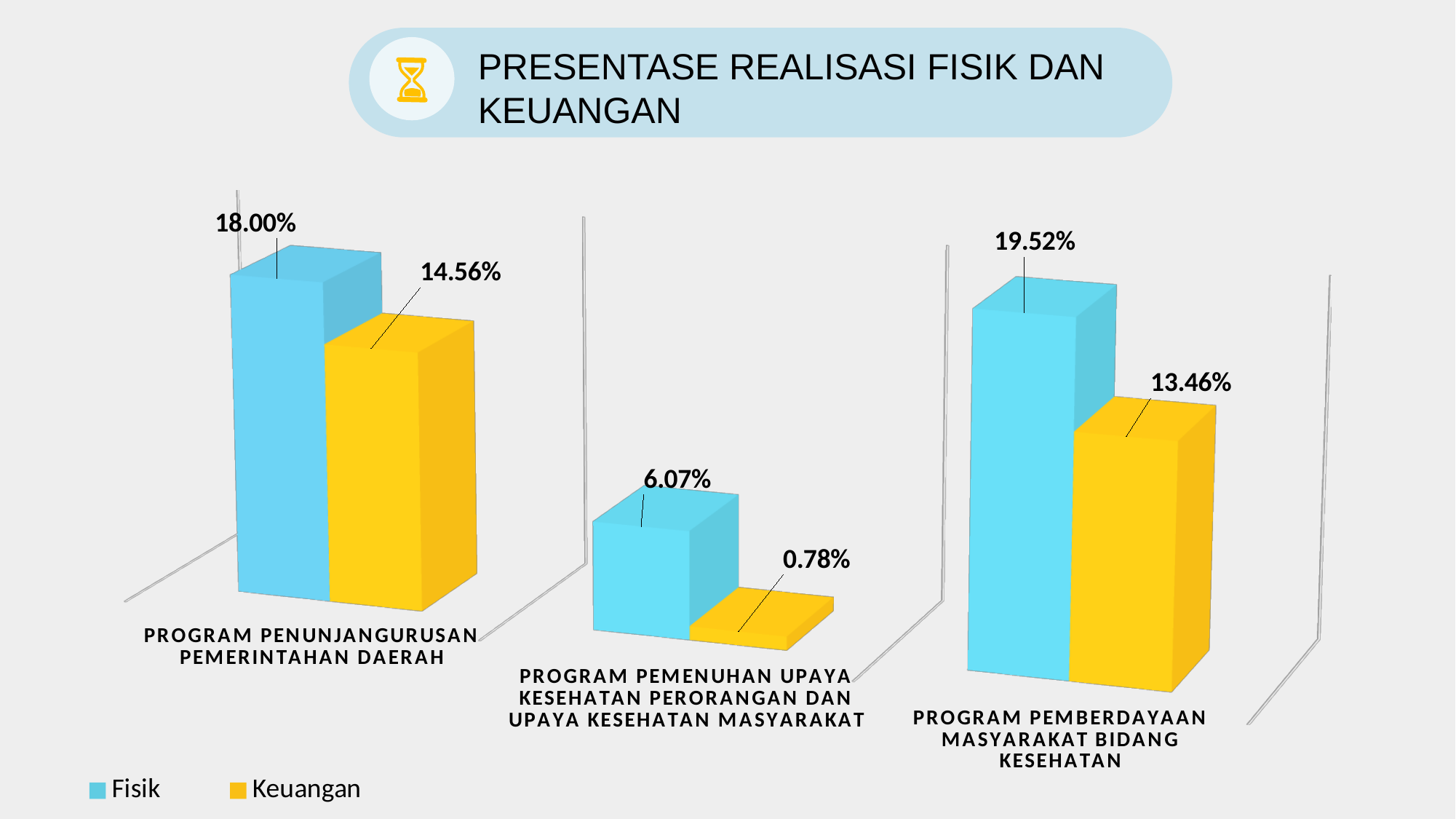
How many series does the legend list? 2 What is the difference between the Fisik values of Program Pemberdayaan Masyarakat Bidang Kesehatan and Program Pemenuhan Upaya Kesehatan Perorangan dan Upaya Kesehatan Masyarakat? 13.45% Which colour represents the Keuangan series in the chart? Yellow How many programs (categories) are shown in the chart? 3 What kind of chart is shown on the slide? Bar chart Which is larger: the Keuangan value for Program Penunjangurusan Pemerintahan Daerah or the Keuangan value for Program Pemberdayaan Masyarakat Bidang Kesehatan? Program Penunjangurusan Pemerintahan Daerah What is the Fisik value for Program Penunjangurusan Pemerintahan Daerah? 18.00% What is the difference between the Fisik and Keuangan values for Program Penunjangurusan Pemerintahan Daerah? 3.44% What is the Keuangan value for Program Pemberdayaan Masyarakat Bidang Kesehatan? 13.46% What is the Keuangan value for Program Pemenuhan Upaya Kesehatan Perorangan dan Upaya Kesehatan Masyarakat? 0.78% Which program has the lowest Keuangan value? Program Pemenuhan Upaya Kesehatan Perorangan dan Upaya Kesehatan Masyarakat Which program has the highest Fisik value? Program Pemberdayaan Masyarakat Bidang Kesehatan